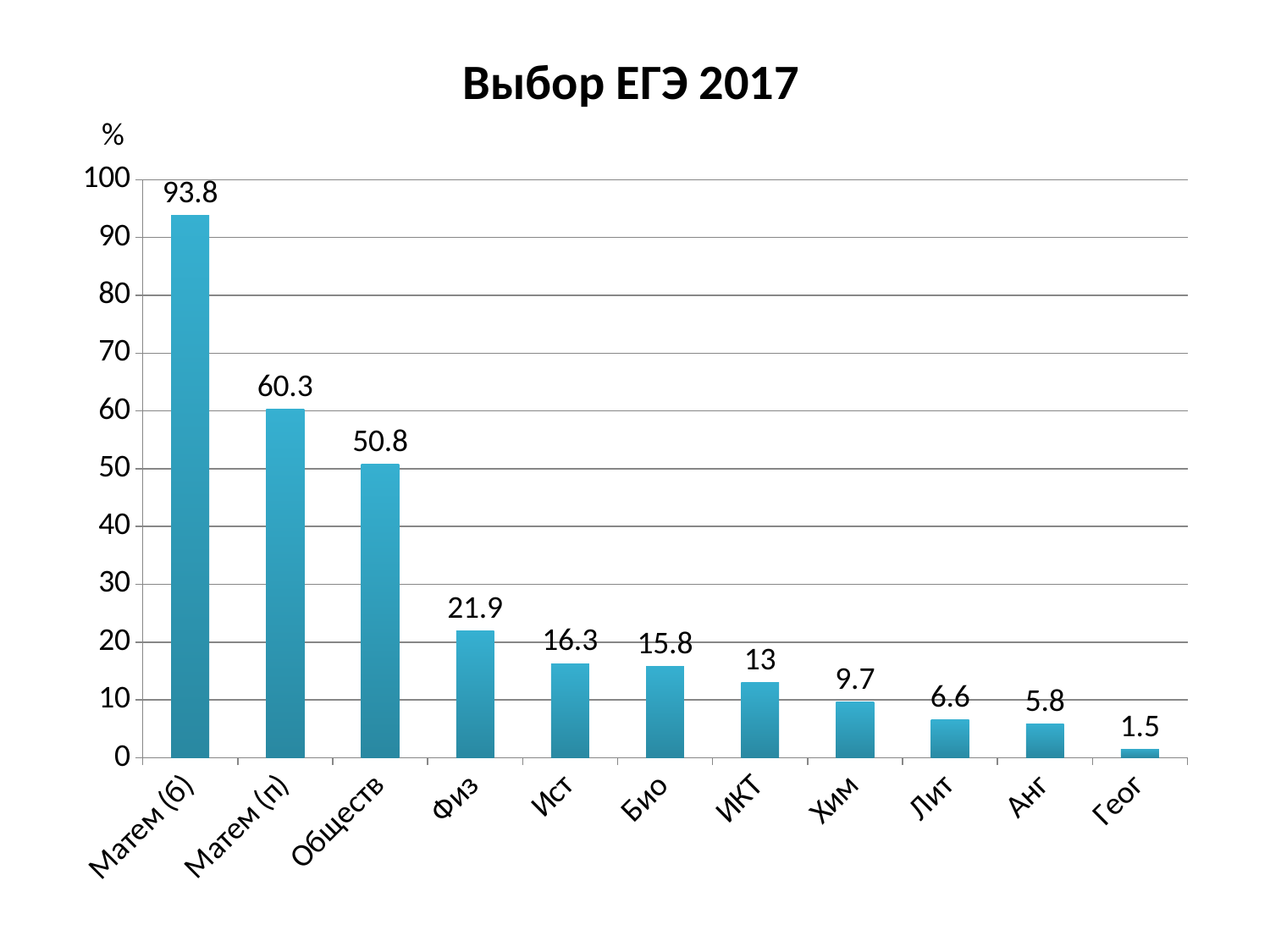
What is the value for ИКТ? 13 Is the value for Обществ greater or less than 50? greater How many categories are shown on the x axis? 11 Which category has the highest value? Матем (б) What kind of chart is this? bar chart What is the title of the chart? Выбор ЕГЭ 2017 Which is larger, the value for Хим or the value for Лит? Хим Which category has the lowest value? Геог What is the value for Матем (б)? 93.8 What is the difference between the values for Обществ and Физ? 28.9 What is the difference between the values for Матем (б) and Матем (п)? 33.5 What is the value for Физ? 21.9